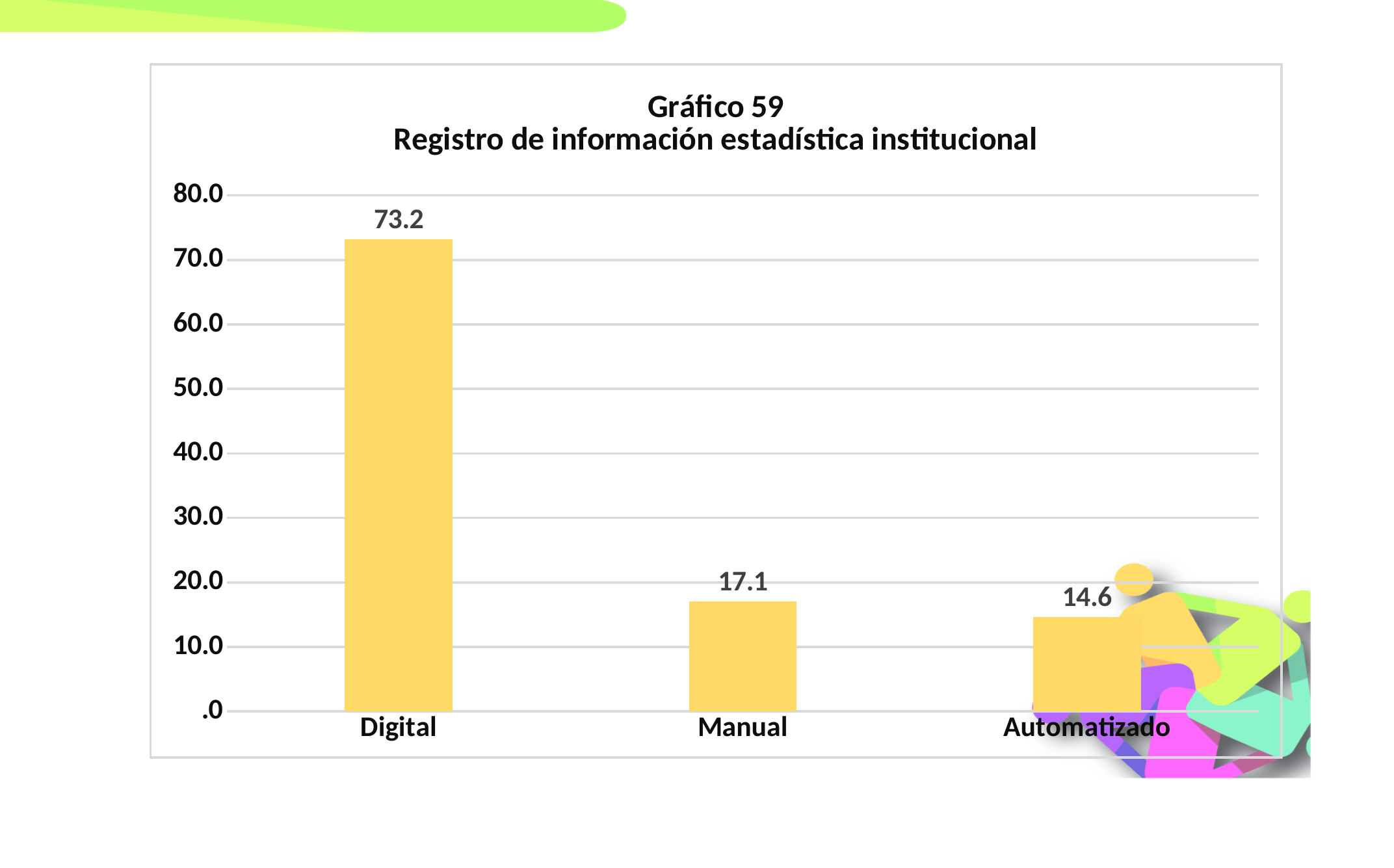
What is the title of the chart? Gráfico 59 Registro de información estadística institucional What is the difference between the values for Digital and Manual? 56.1 What is the value for Digital? 73.2 Is the value for Digital greater or less than 70.0? greater Which category has the highest value? Digital What is the difference between the values for Manual and Automatizado? 2.5 What is the value for Manual? 17.1 Which category has the lowest value? Automatizado What is the value for Automatizado? 14.6 Which is larger, the value for Manual or the value for Automatizado? Manual How many categories are shown on the x axis? 3 What kind of chart is shown on the slide? bar chart